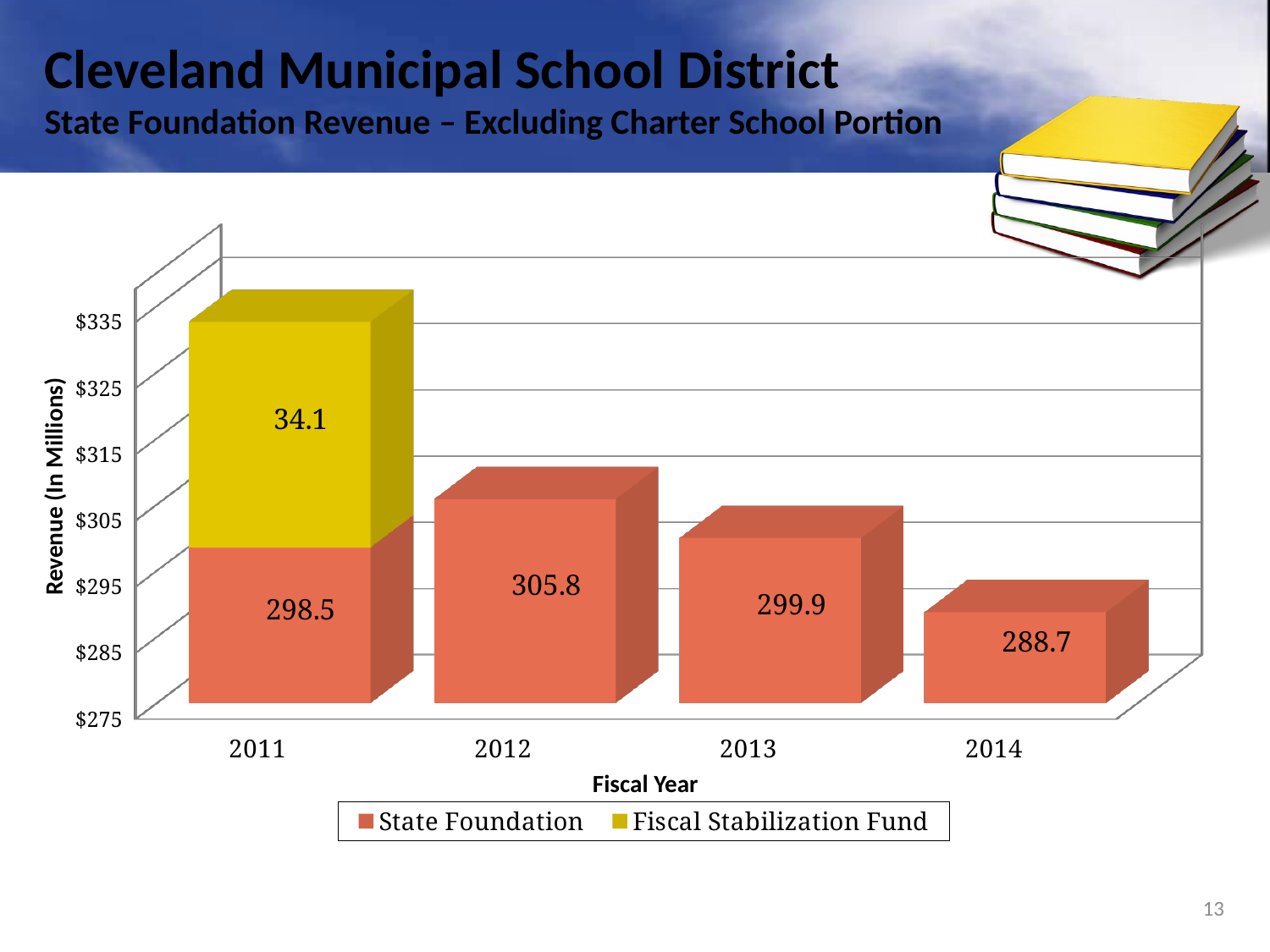
How many fiscal years are shown on the x axis? 4 What is the State Foundation value for fiscal year 2014? 288.7 What is the Fiscal Stabilization Fund value for fiscal year 2011? 34.1 What is the total of the stacked bar for fiscal year 2011? 332.6 Which fiscal year has the lowest State Foundation value? 2014 What is the State Foundation value for fiscal year 2012? 305.8 Which fiscal year has the larger State Foundation value, 2011 or 2013? 2013 Which fiscal year has the highest State Foundation value? 2012 How many series does the legend list? 2 What kind of chart is shown on the slide? bar chart Is the State Foundation value for 2014 greater or less than $295? less What is the difference between the State Foundation values for 2012 and 2014? 17.1